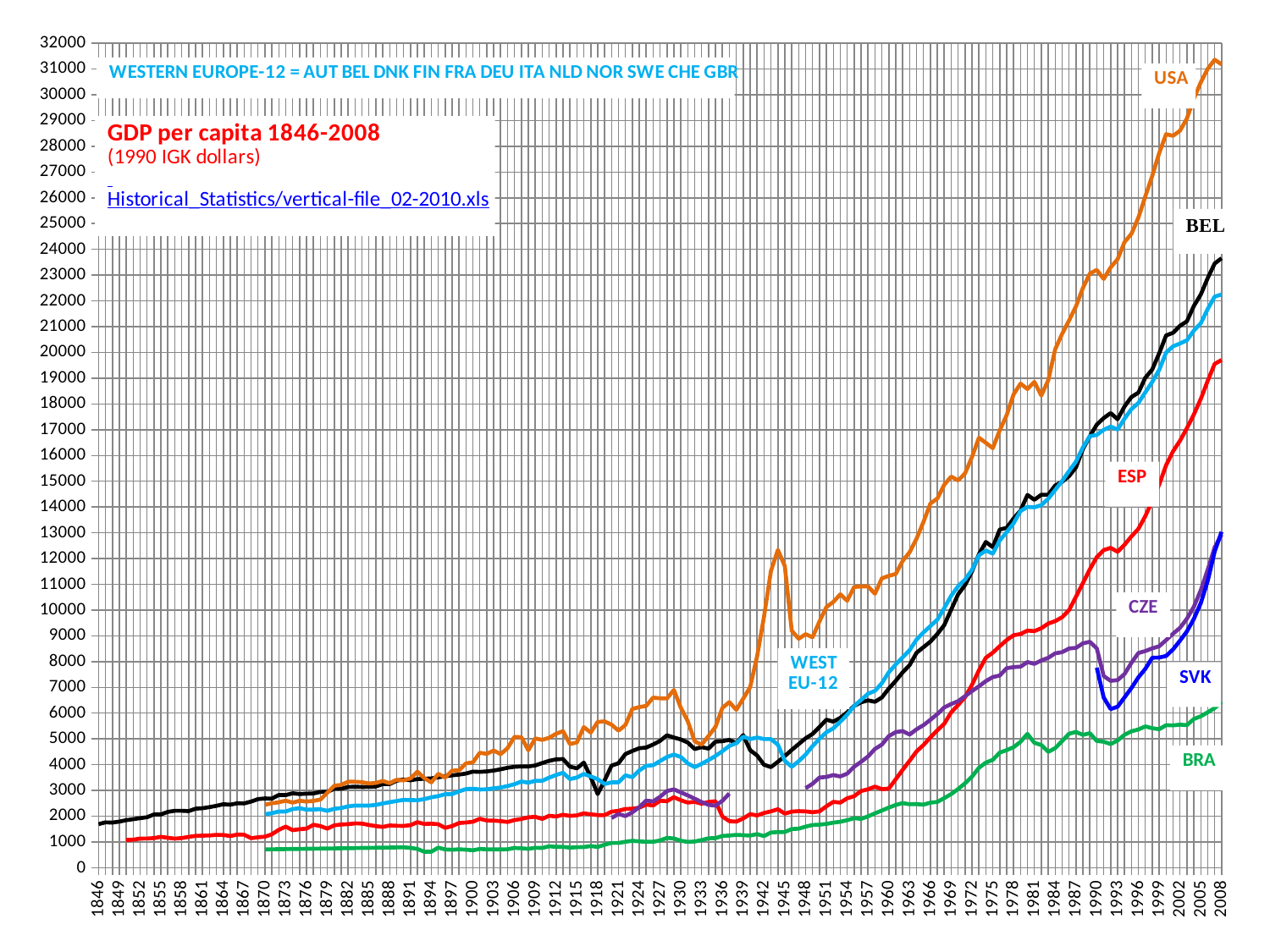
Is the value for USA in 2008 greater or less than 30000? greater What kind of chart is shown on the slide? line chart Is the value for USA in 1945 greater or less than 11000? greater In what units is GDP per capita expressed on the chart? 1990 IGK dollars Which is larger in 2008, the value for BEL or the value for ESP? BEL Which series has the highest GDP per capita in 2008? USA Which series has the lowest GDP per capita in 2008? BRA How many country or region series are labelled on the chart? 7 Is the value for ESP in 2008 greater or less than 18000? greater Does the USA series generally rise or fall from 1846 to 2008? rise What is the title of the chart? GDP per capita 1846-2008